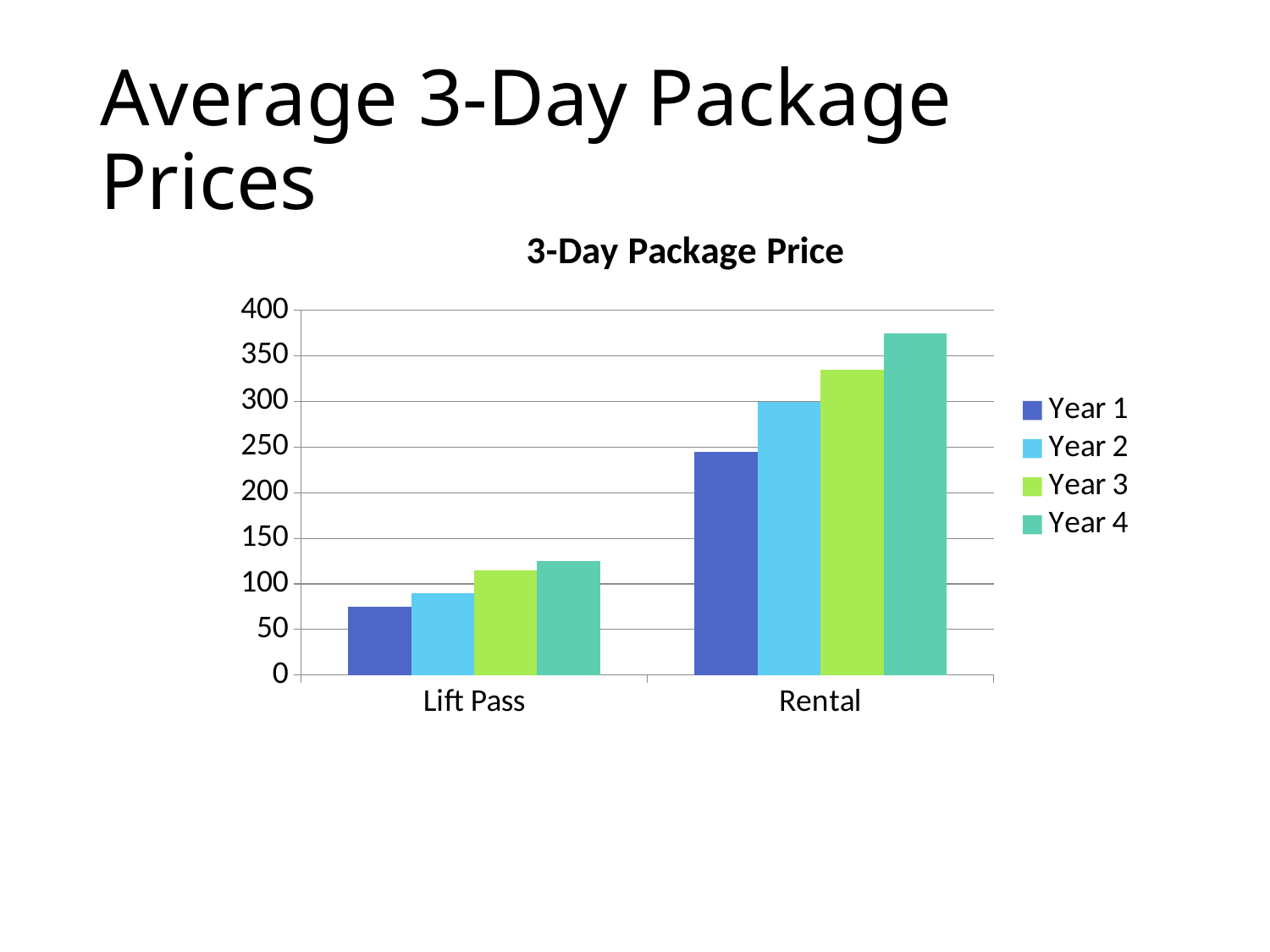
Is the Year 4 value for Lift Pass greater or less than 150? less How many categories are shown on the x axis? 2 What is the title of the chart? 3-Day Package Price Is the Year 1 value for Rental greater or less than 200? greater How many series does the legend list? 4 What kind of chart is shown on the slide? bar chart Which series is shown in the darkest blue colour? Year 1 Within the Lift Pass category, which year has the lowest value? Year 1 Within the Rental category, which year has the highest value? Year 4 Which category has the higher Year 3 value, Lift Pass or Rental? Rental Is the Year 4 value for Rental greater or less than 350? greater